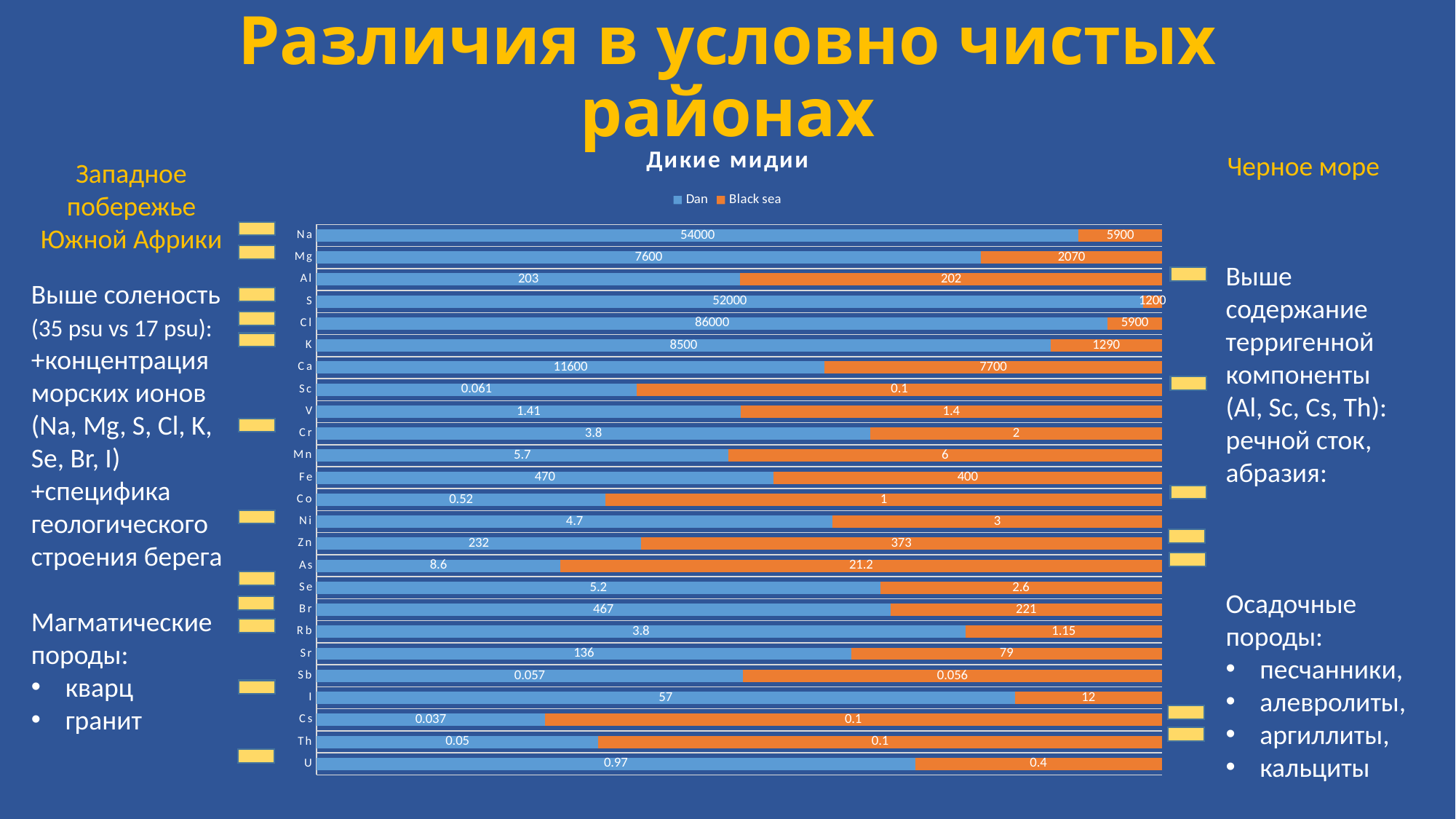
What type of chart is shown on the slide? Stacked bar chart For Th, which series has the larger value, Dan or Black sea? Black sea What is the difference between the Black sea and Dan values for As? 12.6 What is the Dan value for Cs? 0.037 How many series does the legend list? 2 For Sr, which series has the larger value, Dan or Black sea? Dan What is the Black sea value for Zn? 373 What is the difference between the Dan and Black sea values for Fe? 70 What is the Black sea value for Ca? 7700 How many elements (categories) are shown on the chart? 25 What is the Dan value for Na? 54000 Which element has the highest Dan value? Cl